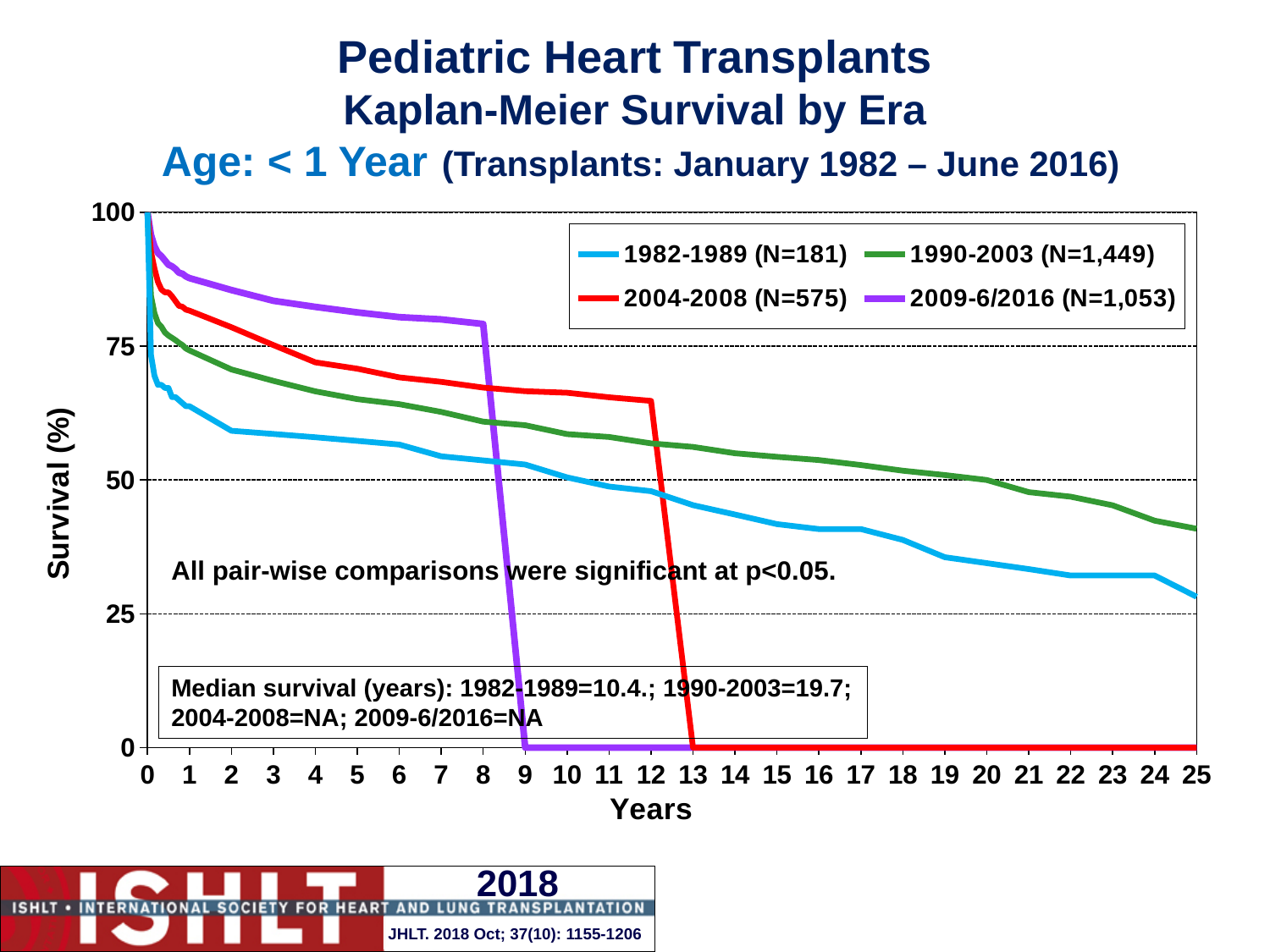
Which era has the lowest survival at year 5? 1982-1989 Which era has the highest survival at year 5? 2009-6/2016 Do the survival curves rise or fall as years increase? fall How many series (eras) does the legend list? 4 Is the survival for the 2009-6/2016 era at year 5 greater or less than 75? greater What is the median survival given for the 2004-2008 era? NA What is the N for the 1990-2003 era shown in the legend? 1,449 What is the median survival in years for the 1982-1989 era? 10.4 At year 20, which era has higher survival, 1990-2003 or 1982-1989? 1990-2003 Is the survival for the 1982-1989 era at year 25 greater or less than 50? less What is the median survival in years for the 1990-2003 era? 19.7 What kind of chart is shown on the slide? line chart